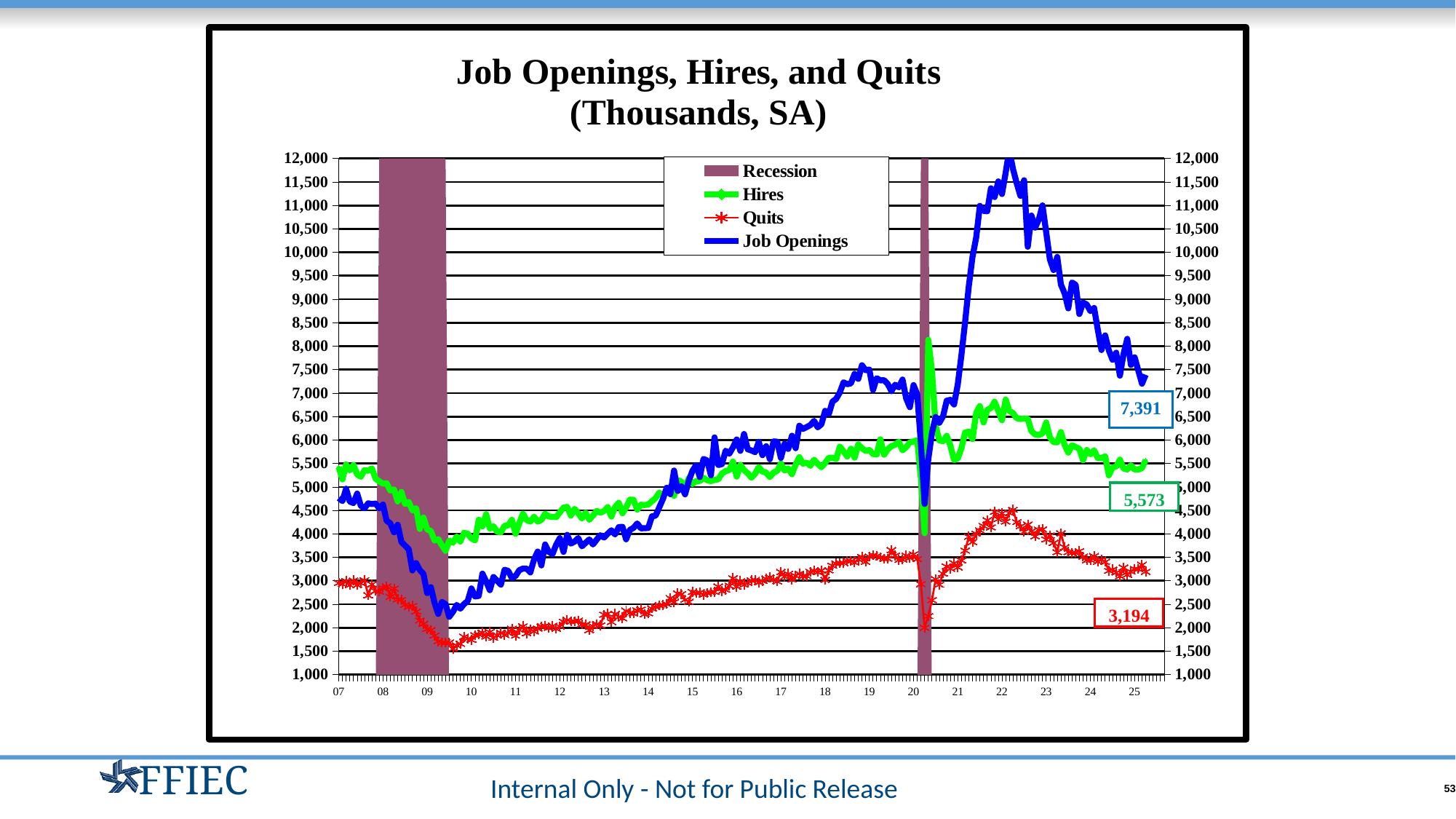
What is the difference between the latest labeled Hires value and the latest labeled Quits value? 2,379 Do Job Openings rise or fall from 2022 to 2025? fall What is the difference between the latest labeled Job Openings value and the latest labeled Hires value? 1,818 What is the latest labeled value for Quits? 3,194 Which series has the lowest latest labeled value? Quits What kind of chart is shown on the slide? line chart Is the peak value of Job Openings around 2022 greater or less than 11,000? greater What is the latest labeled value for Hires? 5,573 How many entries does the legend list? 4 What is the latest labeled value for Job Openings? 7,391 Which series has the highest latest labeled value? Job Openings Is the lowest value of Quits around 2009 greater or less than 2,000? less